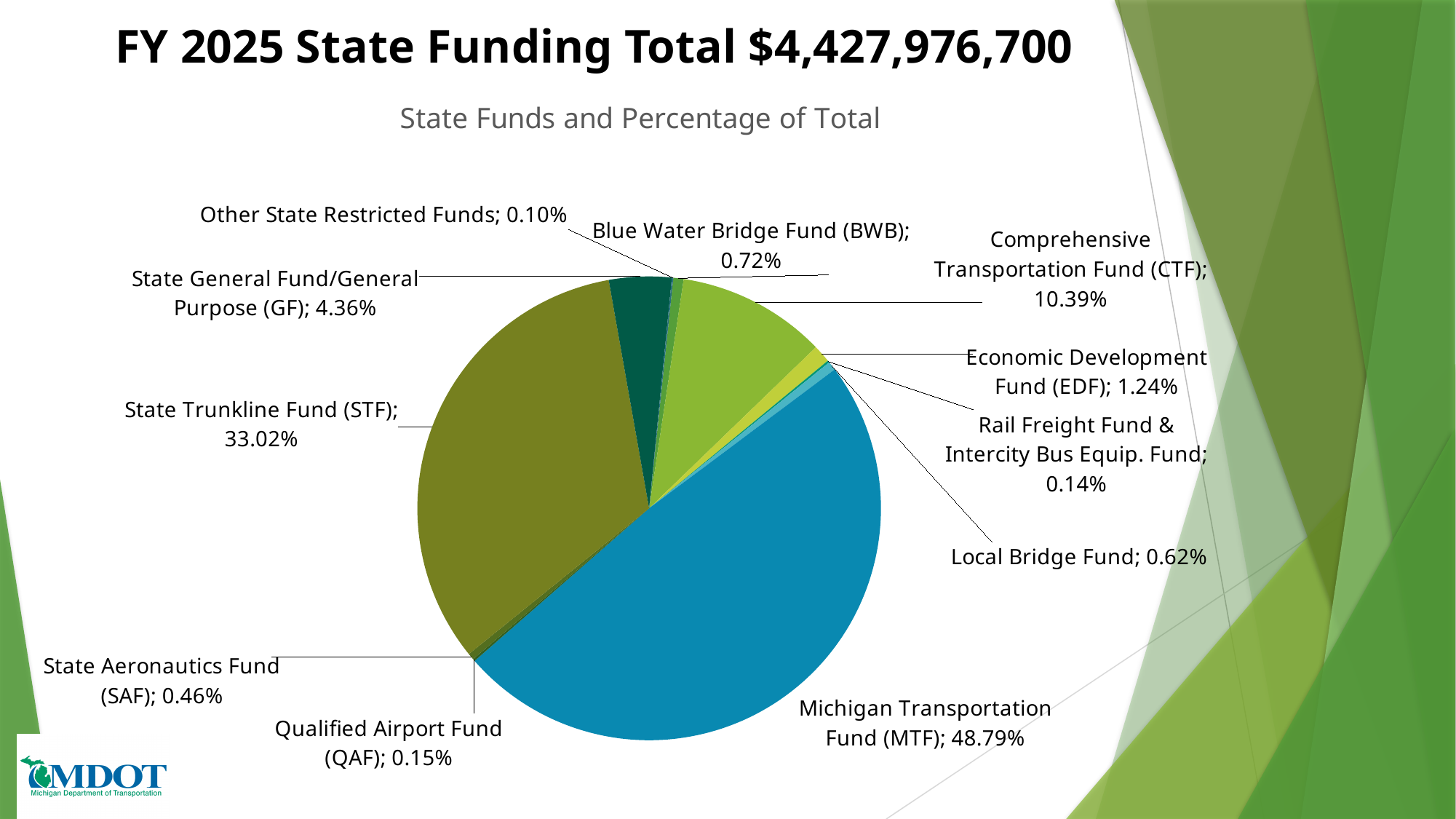
Which fund has the largest share of the pie? Michigan Transportation Fund (MTF) How many slices does the pie chart have? 11 What percentage of the total does the Comprehensive Transportation Fund (CTF) represent? 10.39% What is the FY 2025 State Funding Total stated in the slide title? $4,427,976,700 What percentage of the total does the Economic Development Fund (EDF) represent? 1.24% What is the chart's title? State Funds and Percentage of Total Which is larger, the share for the Blue Water Bridge Fund (BWB) or the share for the Local Bridge Fund? Blue Water Bridge Fund (BWB) What kind of chart is shown on the slide? Pie chart What is the difference in percentage points between the Michigan Transportation Fund (MTF) and the State Trunkline Fund (STF)? 15.77 What percentage of the total does the Michigan Transportation Fund (MTF) represent? 48.79% Which fund has the smallest share of the pie? Other State Restricted Funds What percentage of the total does the State Trunkline Fund (STF) represent? 33.02%